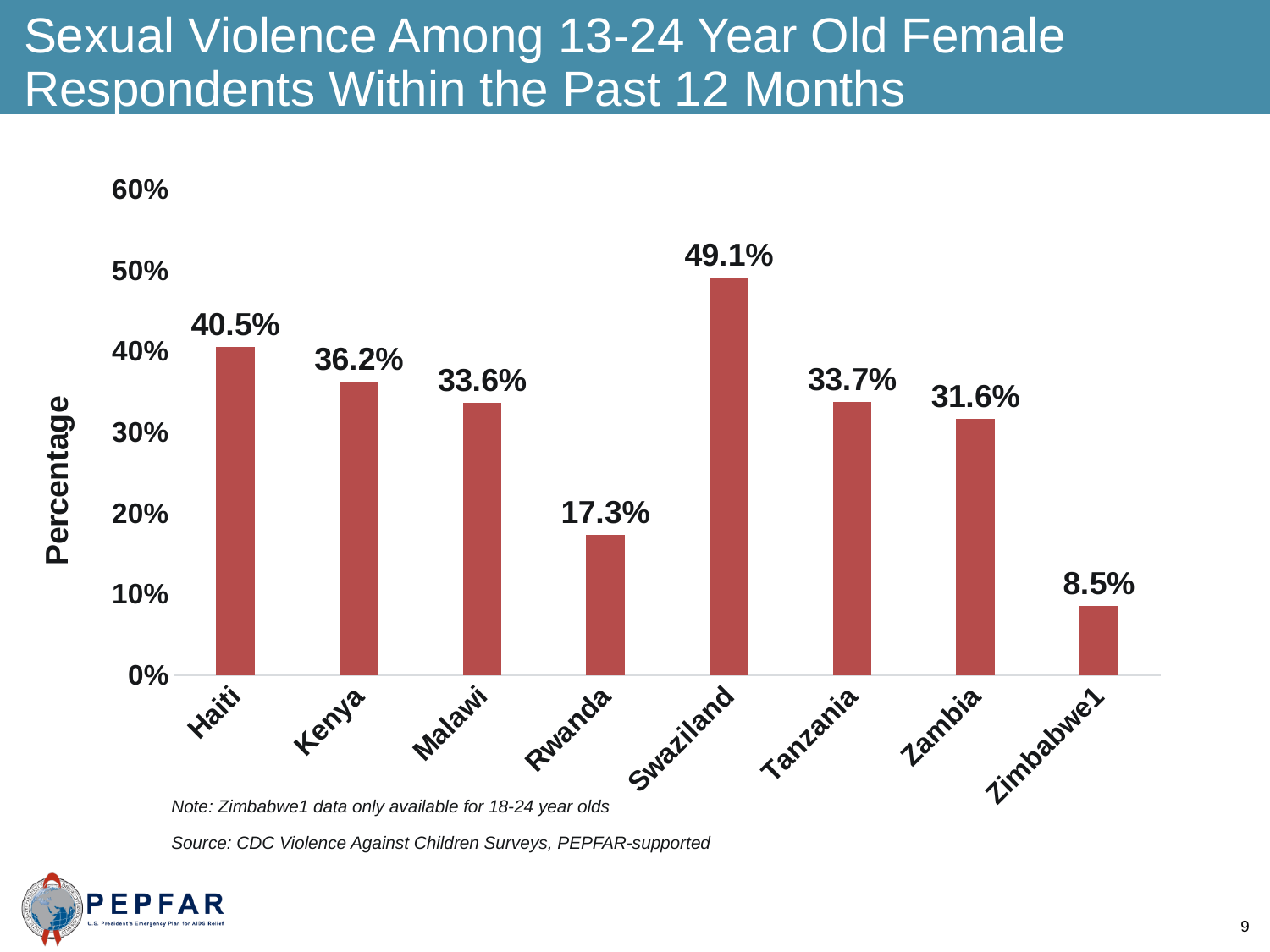
Which country has the lowest value? Zimbabwe1 What is the label of the vertical axis? Percentage What is the value for Rwanda? 17.3% How many countries are shown on the chart? 8 Is the value for Tanzania greater or less than 30%? greater What is the value for Zambia? 31.6% Which is larger, the value for Kenya or the value for Malawi? Kenya What is the difference between the values for Kenya and Rwanda? 18.9% What is the difference between the values for Swaziland and Haiti? 8.6% What is the value for Haiti? 40.5% What kind of chart is shown on the slide? bar chart Which country has the highest value? Swaziland